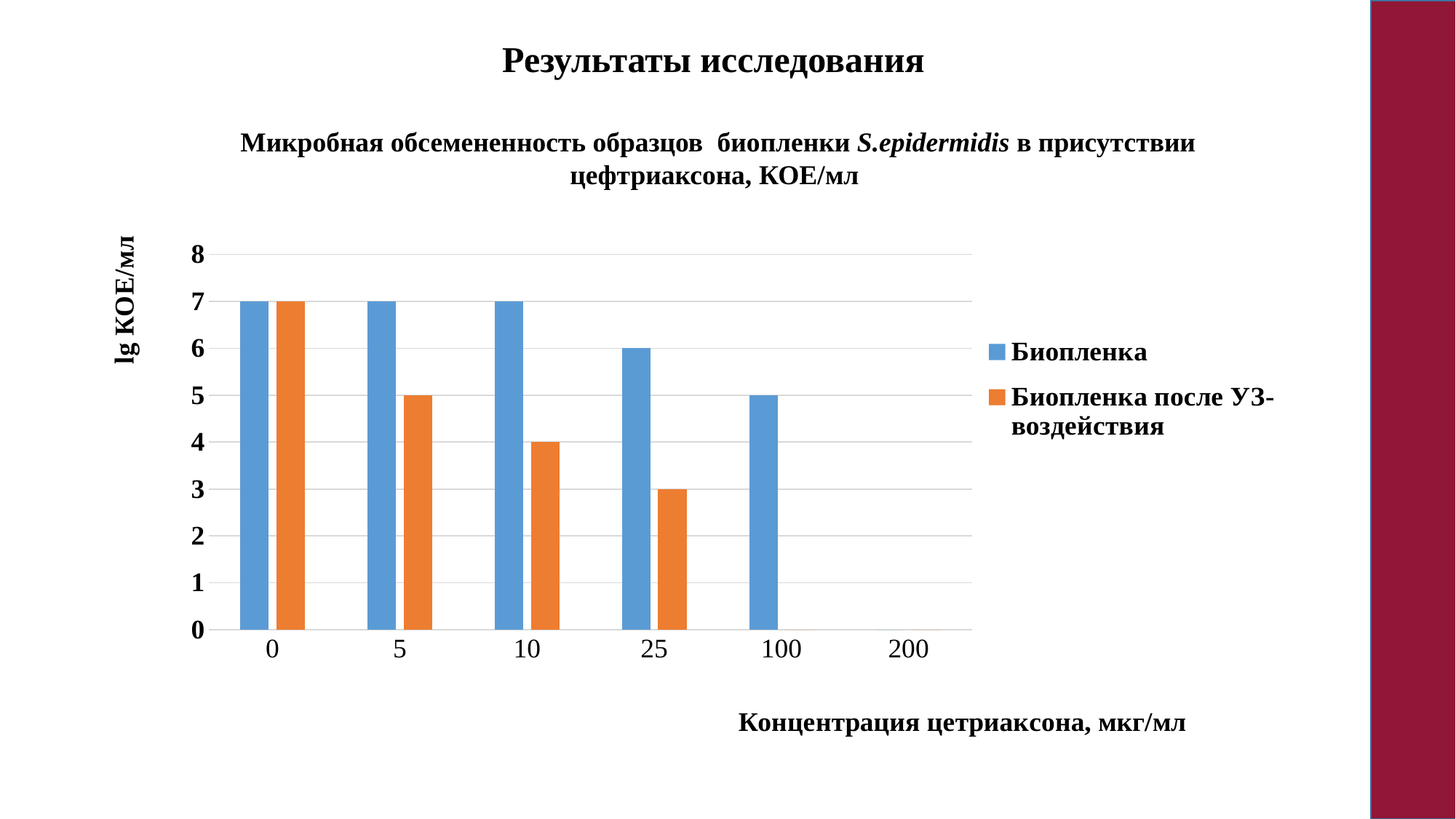
Do the values of "Биопленка после УЗ-воздействия" rise or fall as the concentration increases from 0 to 25? fall What is the value of "Биопленка после УЗ-воздействия" at concentration 10? 4 What is the difference between "Биопленка" and "Биопленка после УЗ-воздействия" at concentration 25? 3 What colour are the bars for "Биопленка после УЗ-воздействия"? orange Which is larger at concentration 5: "Биопленка" or "Биопленка после УЗ-воздействия"? Биопленка What is the value of "Биопленка" at concentration 100? 5 What kind of chart is shown on the slide? bar chart How many concentration categories are shown on the x axis? 6 What is the value of "Биопленка" at concentration 0? 7 What is the value of "Биопленка после УЗ-воздействия" at concentration 25? 3 How many series does the legend list? 2